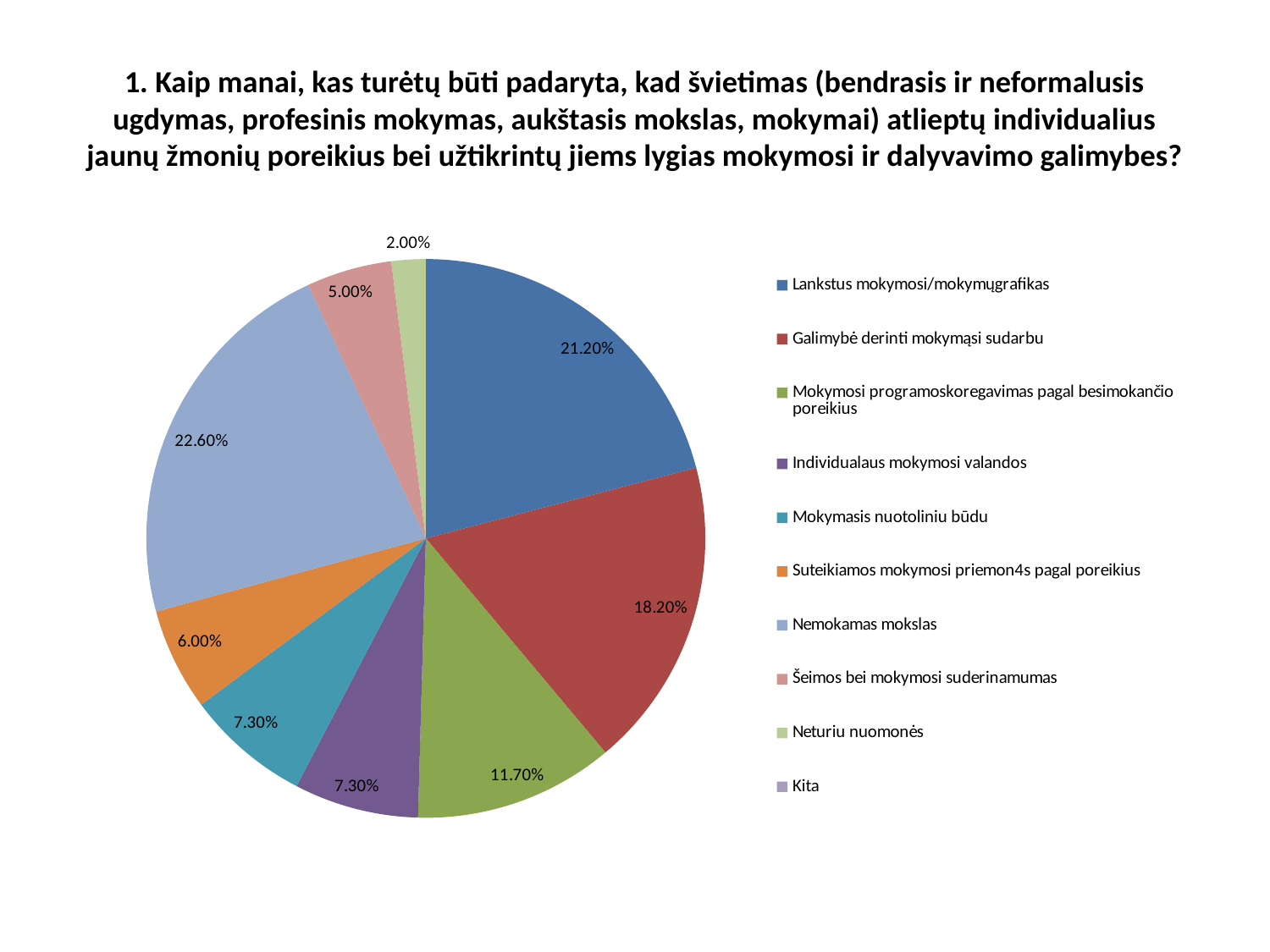
How many entries does the legend list? 10 What percentage is shown for "Neturiu nuomonės"? 2.00% What is the combined share of "Mokymasis nuotoliniu būdu" and "Individualaus mokymosi valandos"? 14.60% What type of chart is shown on the slide? Pie chart What is the difference between the shares for "Nemokamas mokslas" and "Lankstus mokymosi/mokymų grafikas"? 1.40% What is the value for "Galimybė derinti mokymąsi su darbu"? 18.20% What percentage is shown for "Lankstus mokymosi/mokymų grafikas"? 21.20% What share of the pie does "Nemokamas mokslas" have? 22.60% What colour is the slice for "Suteikiamos mokymosi priemonės pagal poreikius"? Orange Which is larger: the share for "Galimybė derinti mokymąsi su darbu" or for "Mokymosi programos koregavimas pagal besimokančio poreikius"? Galimybė derinti mokymąsi su darbu Which labelled slice is the smallest in the pie? Neturiu nuomonės Which category has the largest slice of the pie? Nemokamas mokslas